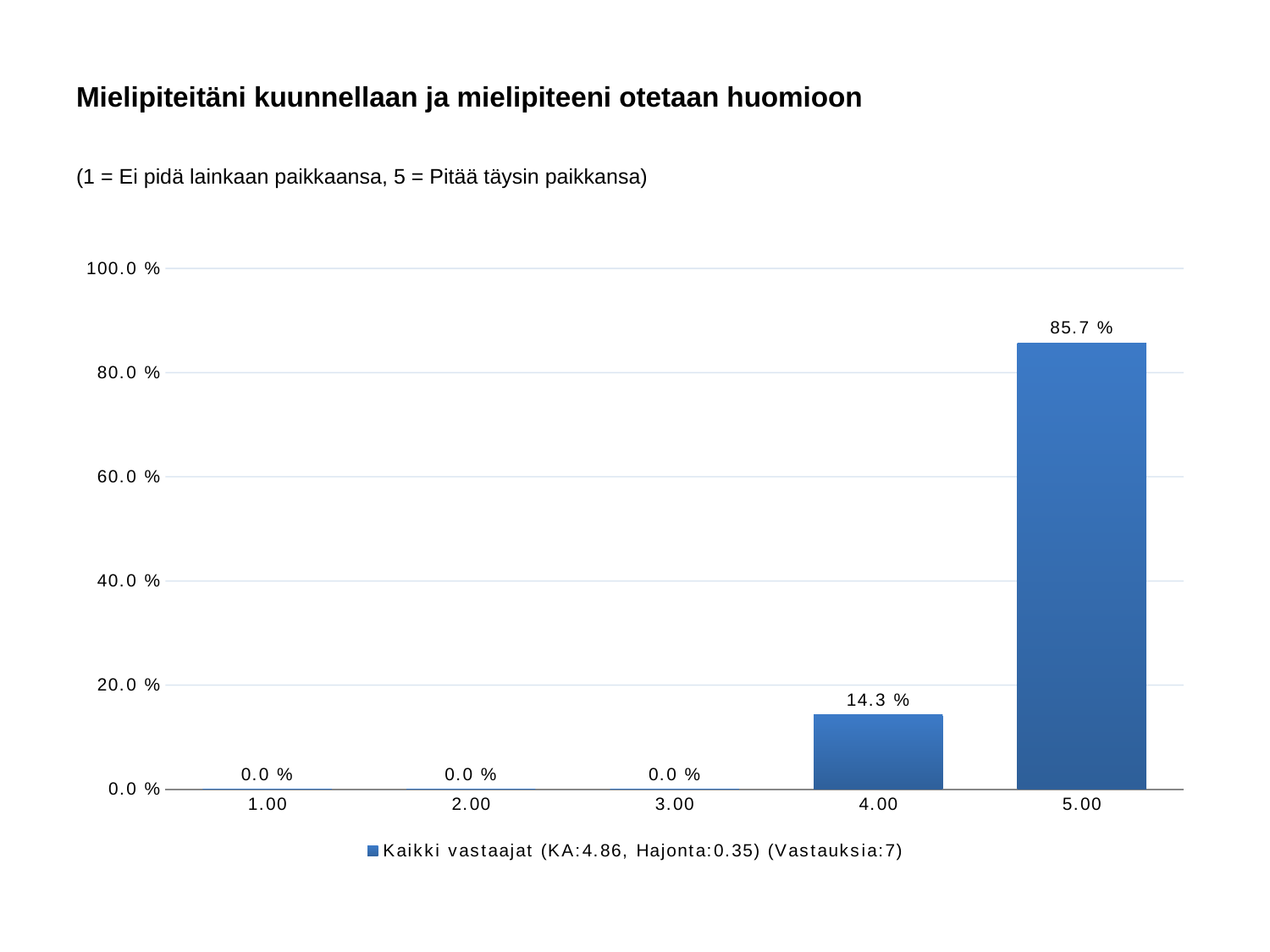
What is the value for category 5.00? 85.7 % Which is larger, the value for 4.00 or the value for 5.00? 5.00 What kind of chart is shown? bar chart Is the value for 5.00 greater or less than 80.0 %? greater What is the value for category 4.00? 14.3 % What is the difference between the values for 5.00 and 4.00? 71.4 % How many series does the legend list? 1 How many categories are shown on the x axis? 5 Which category has the highest value? 5.00 How many responses (Vastauksia) does the legend report? 7 Is the value for 4.00 greater or less than 20.0 %? less What is the value for category 1.00? 0.0 %